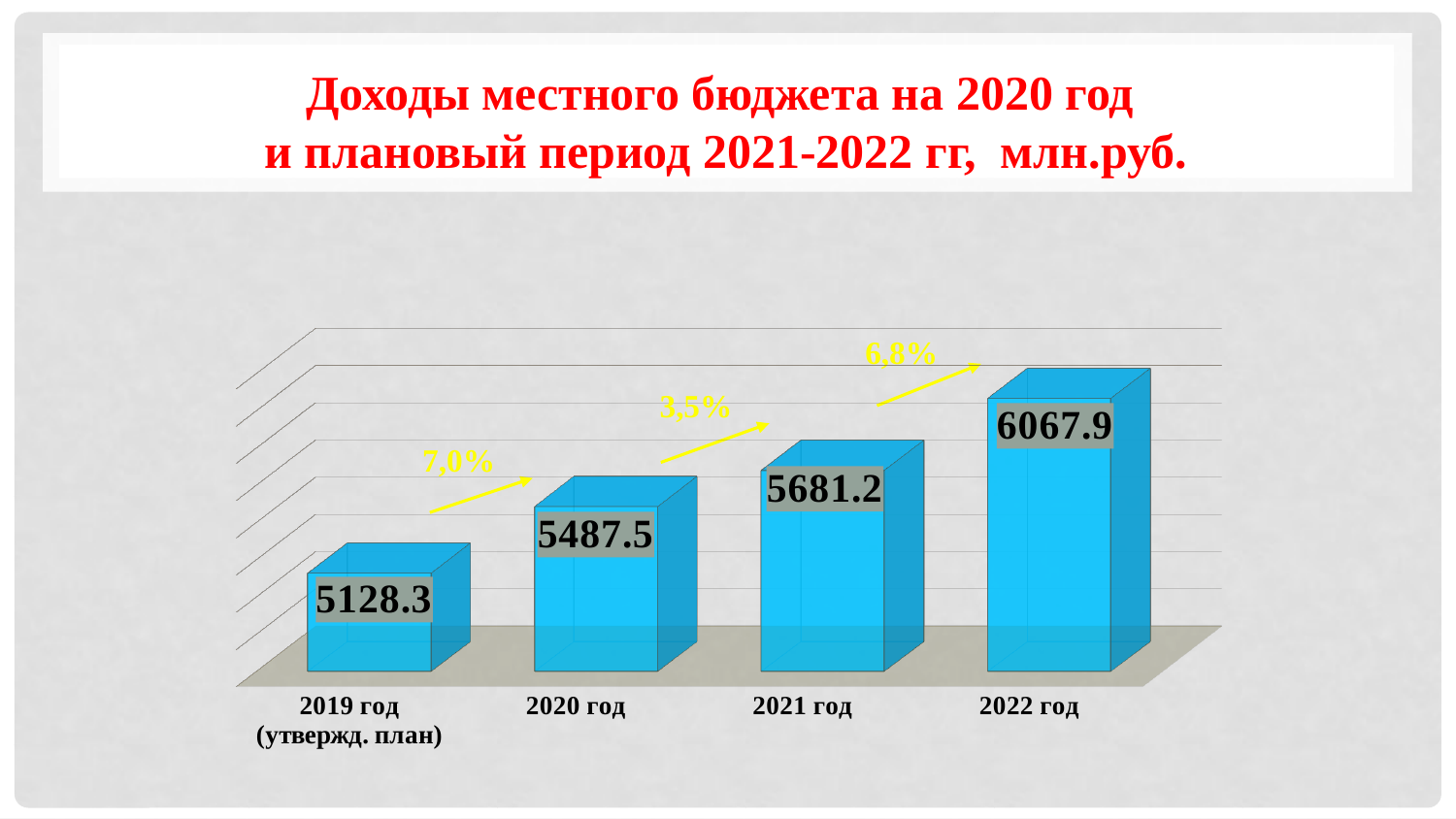
What is the difference between the values for 2022 год and 2021 год? 386.7 How many bars are shown in the chart? 4 What is the value shown for 2020 год? 5487.5 What kind of chart is shown on the slide? bar chart Which year has the highest value? 2022 год What is the value shown for 2019 год (утвержд. план)? 5128.3 Do the values rise or fall from 2019 год to 2022 год? rise Which year has the lowest value? 2019 год (утвержд. план) What is the value shown for 2021 год? 5681.2 What is the difference between the values for 2020 год and 2019 год (утвержд. план)? 359.2 What is the value shown for 2022 год? 6067.9 Which is larger, the value for 2021 год or the value for 2020 год? 2021 год